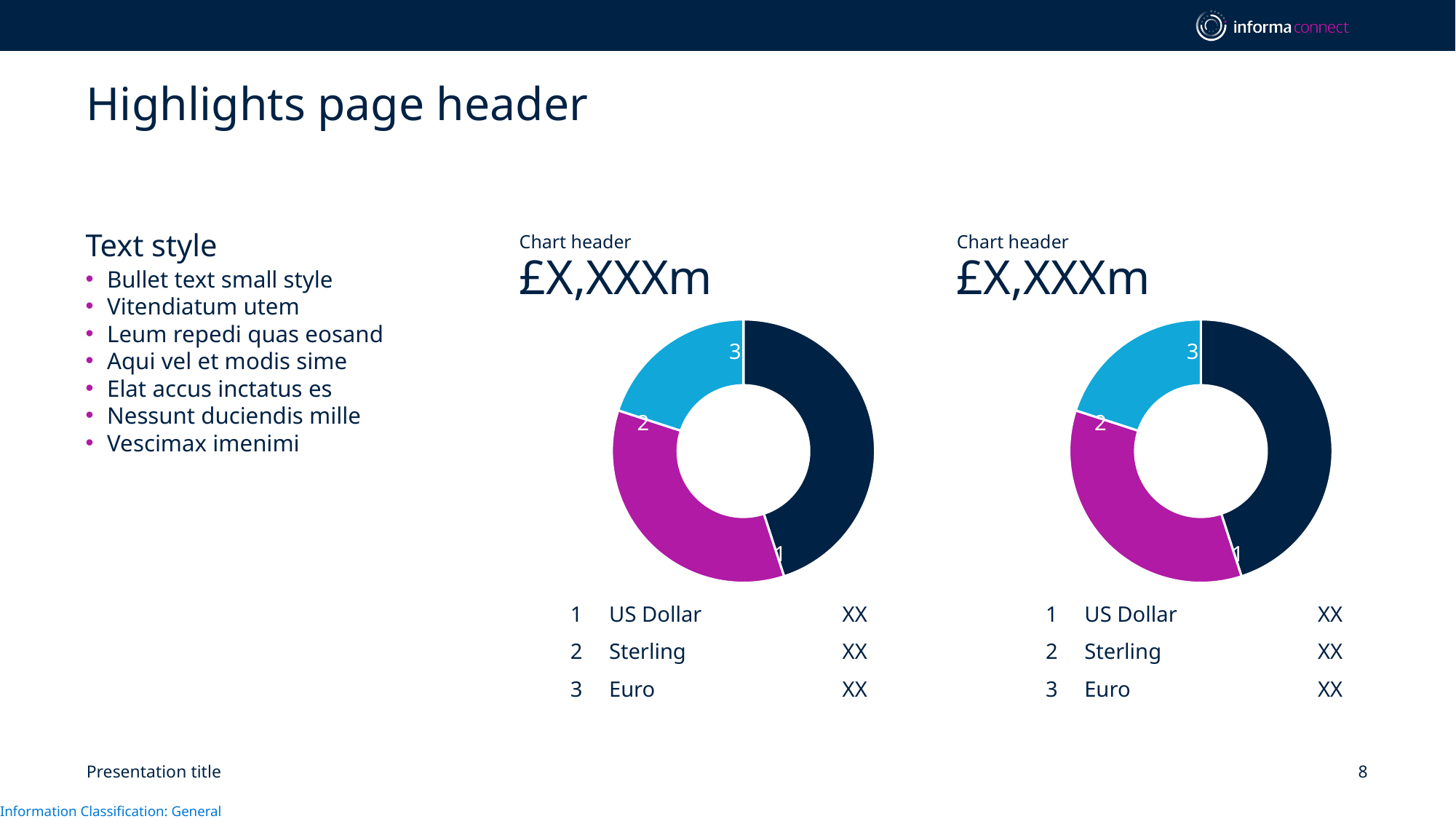
What number label is on the light blue slice of the right donut chart? 3 How many categories does the left donut chart have? 3 In the left donut chart, which category is shown in magenta? Sterling In the left donut chart, which category has the smallest slice? Euro In the left donut chart, which slice is larger, US Dollar or Sterling? US Dollar What type of chart is shown on the left side of the slide? donut chart In the left donut chart, which slice is larger, Sterling or Euro? Sterling How many categories does the right donut chart have? 3 In the right donut chart, which category has the largest slice? US Dollar In the right donut chart, which slice is larger, US Dollar or Euro? US Dollar In the left donut chart, which category has the largest slice? US Dollar In the right donut chart, which category has the smallest slice? Euro